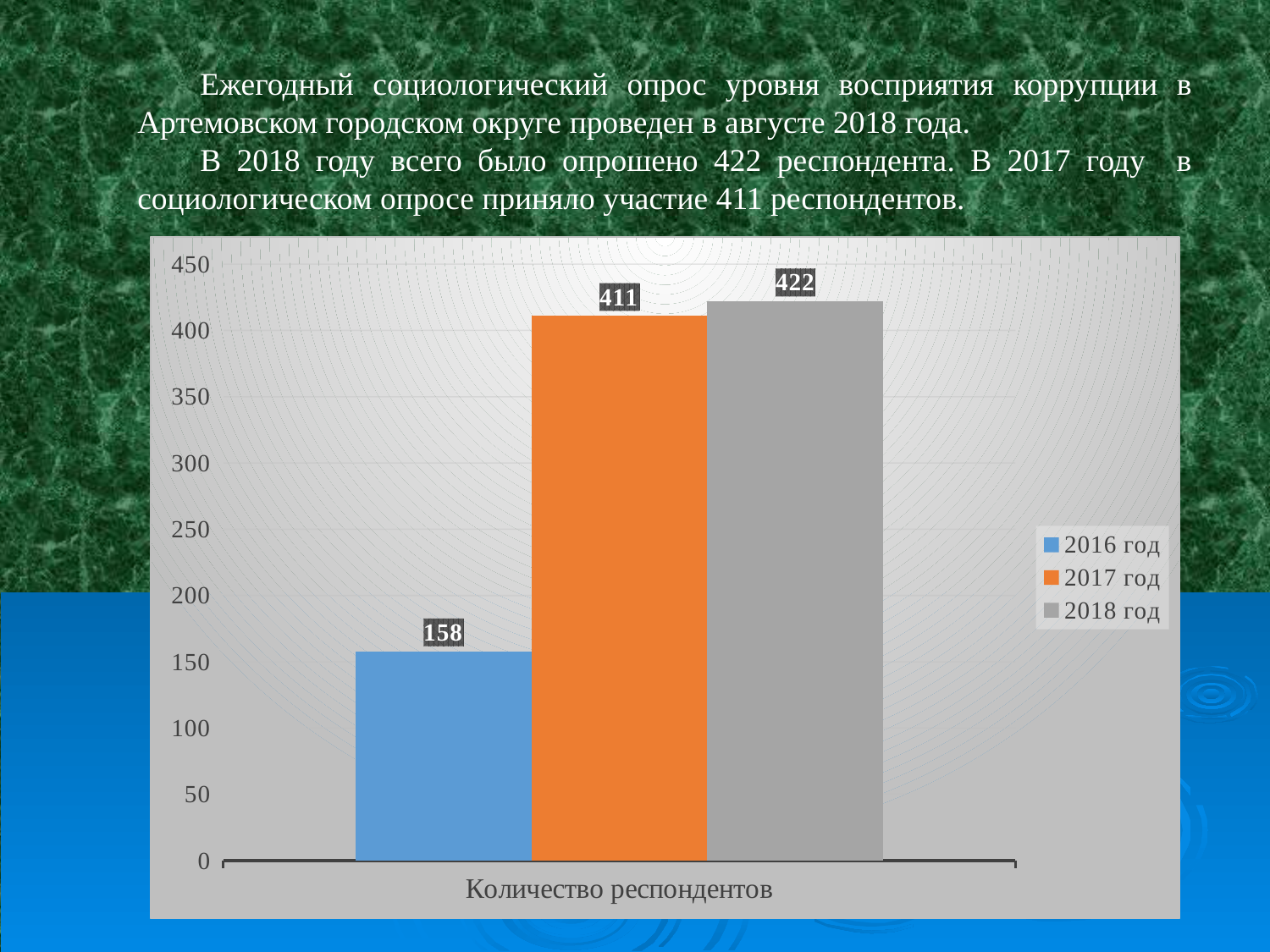
Which series has the lowest value? 2016 год Which is larger, the value for 2016 год or the value for 2017 год? 2017 год Which series has the highest value? 2018 год Is the value for 2016 год greater or less than 200? less What is the difference between the values for 2018 год and 2017 год? 11 What is the category label shown on the x axis of the chart? Количество респондентов What kind of chart is shown on the slide? bar chart What is the value for 2016 год in the chart? 158 What is the value for 2017 год in the chart? 411 How many series does the legend list? 3 What is the difference between the values for 2017 год and 2016 год? 253 What is the value for 2018 год in the chart? 422